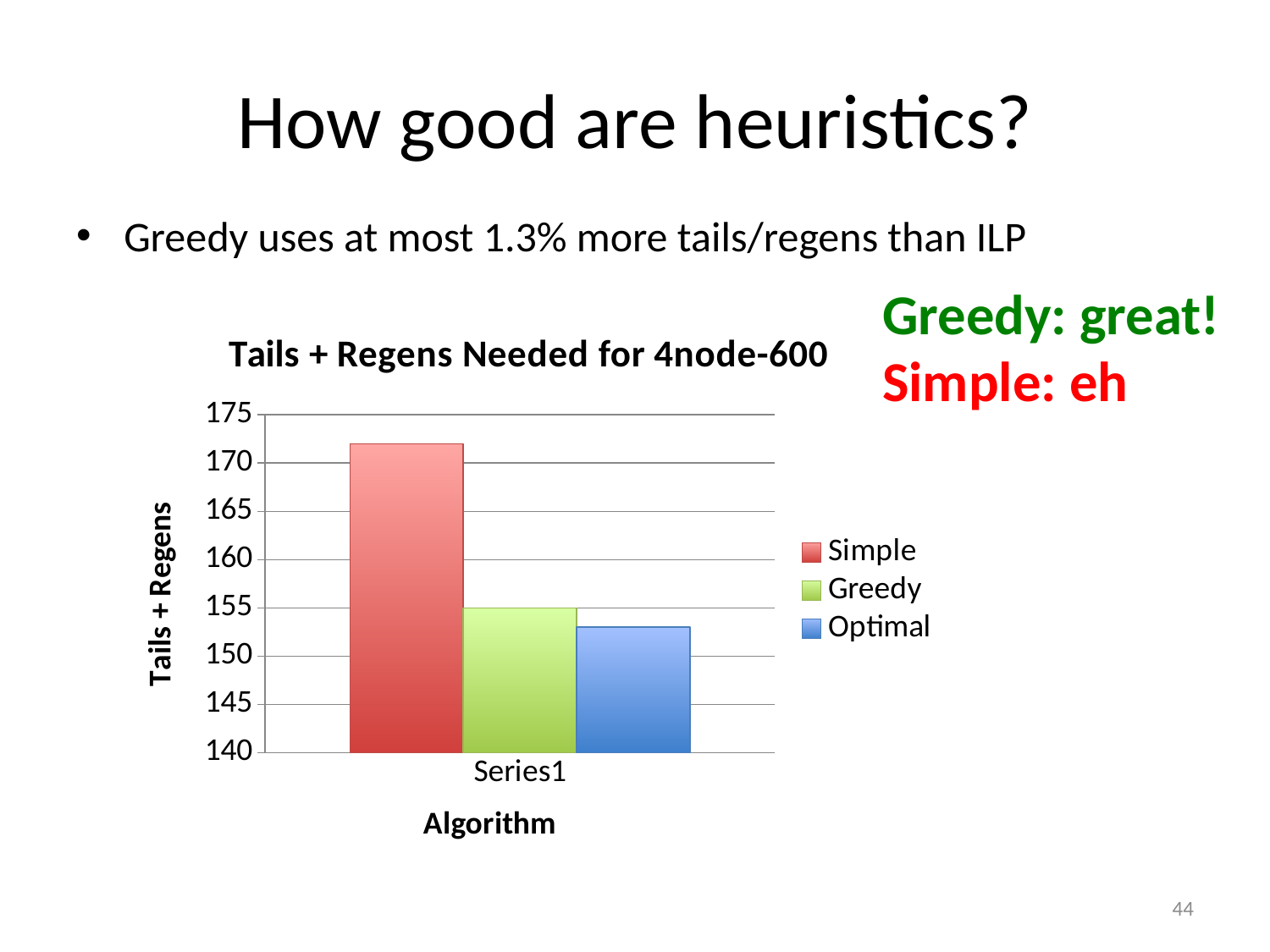
Is the value for Simple greater or less than 170? greater Which series has the lowest value? Optimal Is the value for Greedy greater or less than 160? less What kind of chart is shown on the slide? bar chart How many series does the legend list? 3 Is the value for Optimal greater or less than 155? less Which is larger, the value for Simple or the value for Greedy? Simple What is the label of the vertical axis? Tails + Regens Which is larger, the value for Greedy or the value for Optimal? Greedy What is the title of the chart? Tails + Regens Needed for 4node-600 Which series has the highest value? Simple